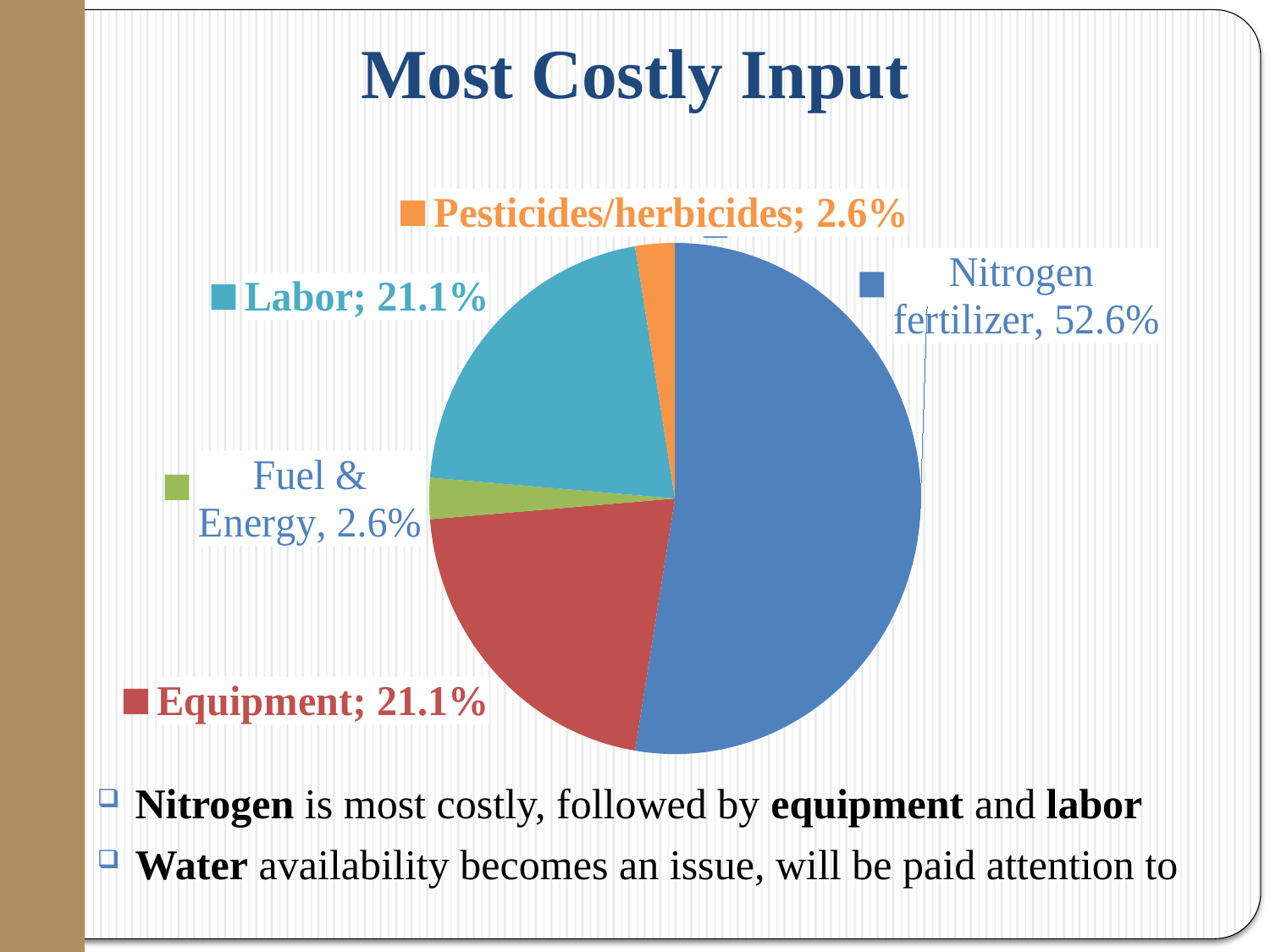
What is the value shown for Equipment? 21.1% What is the value shown for Labor? 21.1% What is the value shown for Pesticides/herbicides? 2.6% What kind of chart is shown on the slide? pie chart Which category has the largest slice of the pie? Nitrogen fertilizer What is the difference between the Nitrogen fertilizer share and the Labor share? 31.5% What share of the pie does Nitrogen fertilizer account for? 52.6% What is the combined share of Labor and Equipment? 42.2% Which is larger, the Equipment slice or the Fuel & Energy slice? Equipment What is the title of the slide containing the pie chart? Most Costly Input How many categories are shown in the pie chart? 5 What is the value shown for Fuel & Energy? 2.6%